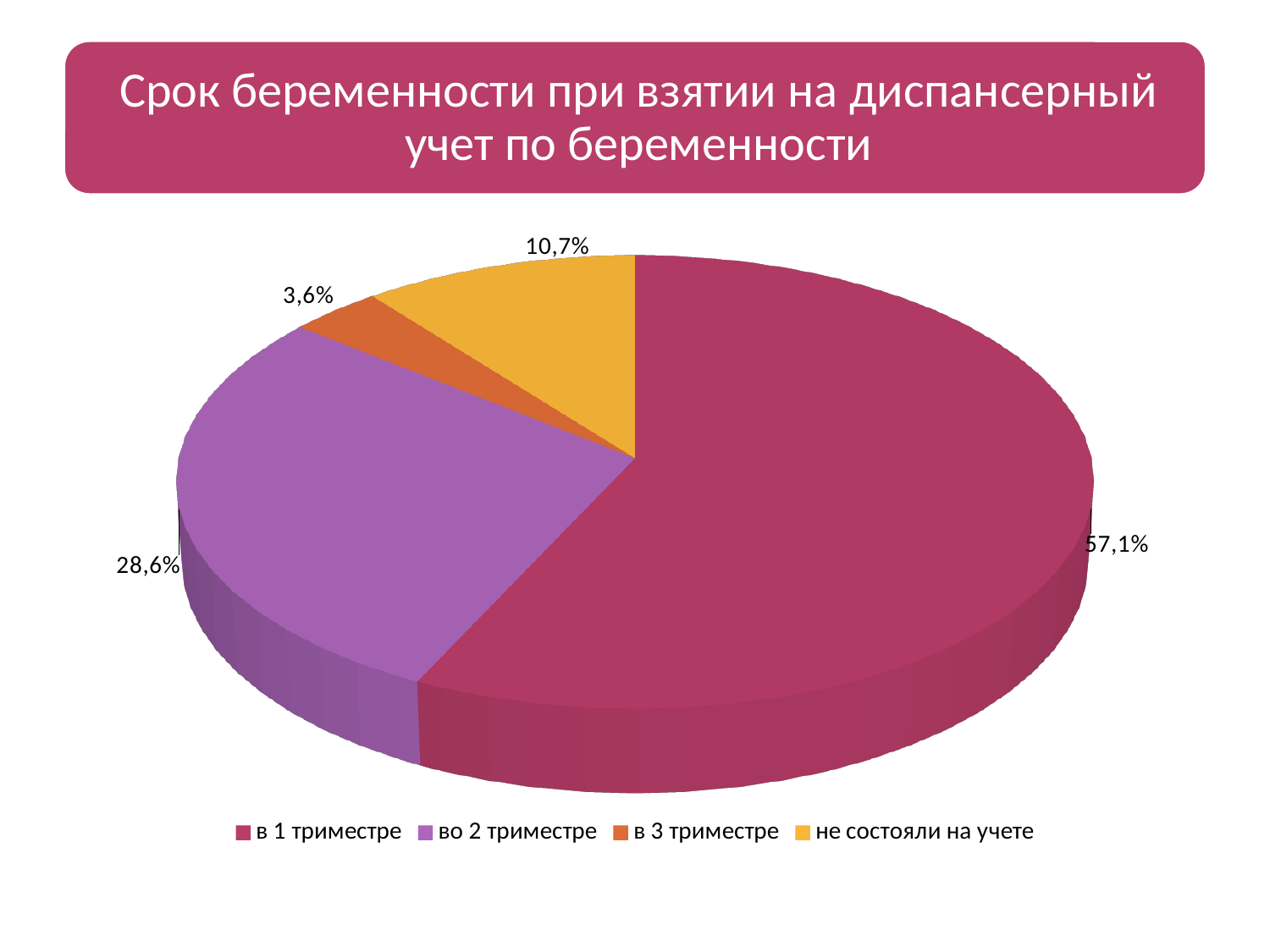
How many slices does the pie chart have? 4 What kind of chart is shown on the slide? pie chart Which is larger: the slice for 'не состояли на учете' or the slice for 'в 3 триместре'? не состояли на учете Which category has the smallest slice of the pie? в 3 триместре What share of the pie is labelled for 'в 1 триместре'? 57,1% What is the difference in percentage points between 'в 1 триместре' and 'во 2 триместре'? 28,5 Which category has the largest slice of the pie? в 1 триместре What share of the pie is labelled for 'в 3 триместре'? 3,6% What share of the pie is labelled for 'во 2 триместре'? 28,6% How many entries does the legend list? 4 What is the title of the slide? Срок беременности при взятии на диспансерный учет по беременности What share of the pie is labelled for 'не состояли на учете'? 10,7%